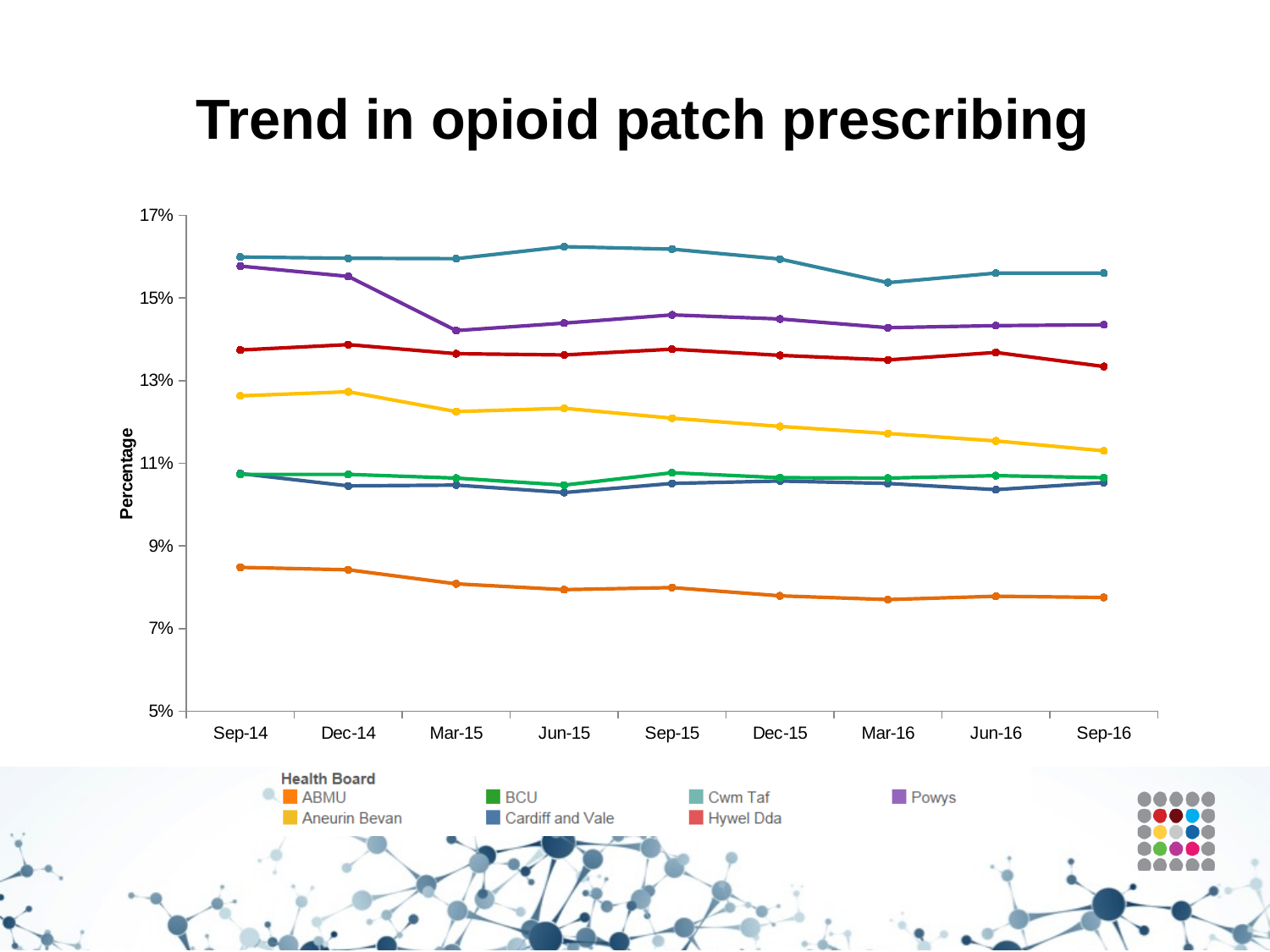
Which health board has the lowest percentage at Sep-16? ABMU Is the value for Hywel Dda at Sep-14 greater or less than 13%? greater What is the label on the y axis? Percentage Does the percentage for Aneurin Bevan rise or fall from Sep-14 to Sep-16? fall Which health board has the highest percentage at Sep-16? Cwm Taf Is the value for ABMU at Sep-16 greater or less than 9%? less Is the value for Cwm Taf at Sep-14 greater or less than 15%? greater At Sep-16, which is higher: Powys or Hywel Dda? Powys What kind of chart is shown on the slide? line chart How many health boards does the legend list? 7 How many time points are shown along the x axis? 9